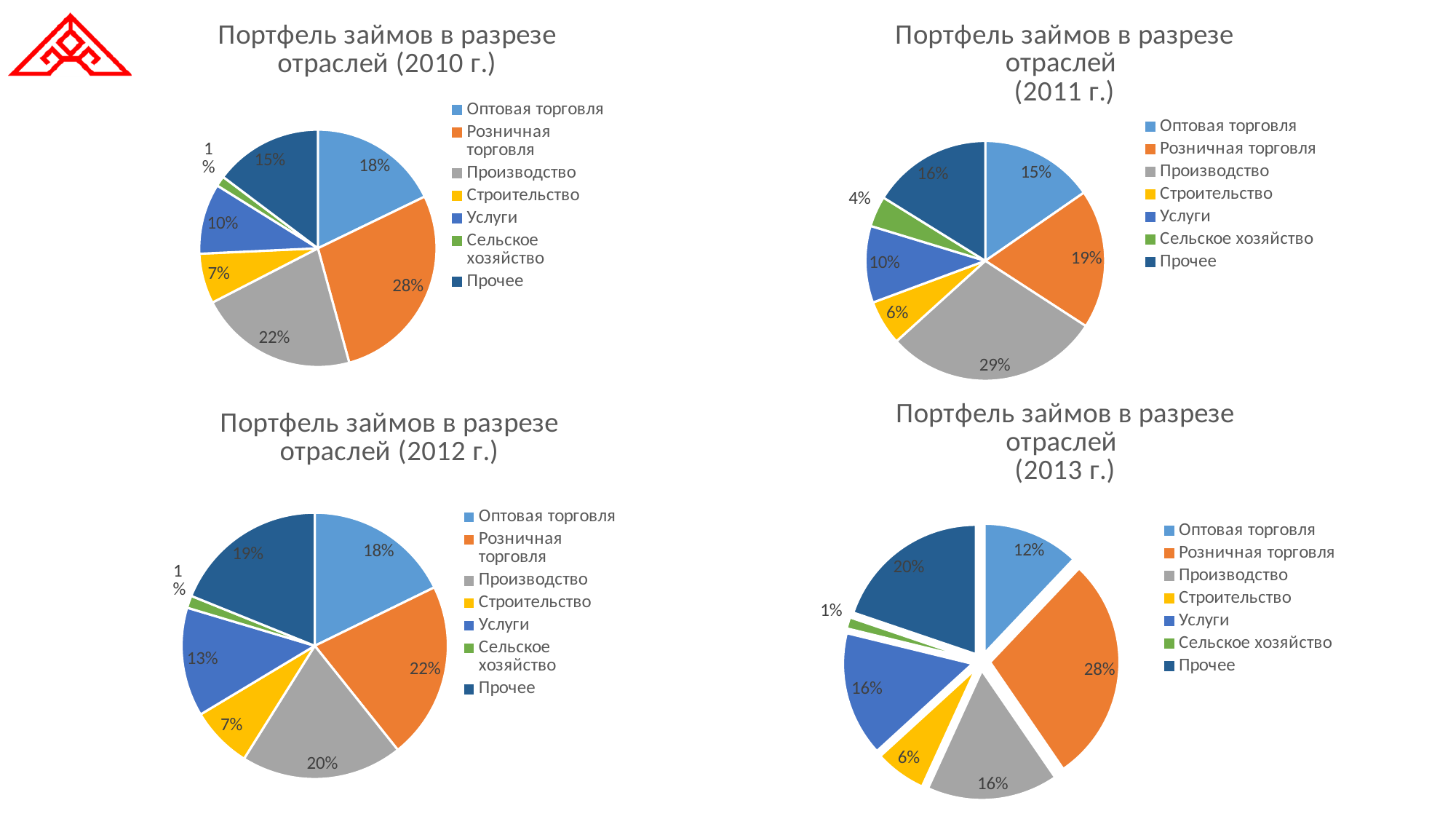
In the chart titled "Портфель займов в разрезе отраслей (2012 г.)", which is larger: Услуги or Строительство? Услуги In the chart titled "Портфель займов в разрезе отраслей (2010 г.)", what share does Розничная торговля have? 28% In the chart titled "Портфель займов в разрезе отраслей (2011 г.)", what is the share of Сельское хозяйство? 4% How many pie charts are shown on the slide? 4 In the chart titled "Портфель займов в разрезе отраслей (2013 г.)", what is the share of Прочее? 20% How many categories does the legend list in the chart titled "Портфель займов в разрезе отраслей (2010 г.)"? 7 In the chart titled "Портфель займов в разрезе отраслей (2011 г.)", what is the difference between the shares of Производство and Розничная торговля? 10% In the chart titled "Портфель займов в разрезе отраслей (2013 г.)", what is the difference between the shares of Розничная торговля and Оптовая торговля? 16% In the chart titled "Портфель займов в разрезе отраслей (2012 г.)", which category has the smallest share? Сельское хозяйство In the chart titled "Портфель займов в разрезе отраслей (2010 г.)", what is the share of Услуги? 10% In the chart titled "Портфель займов в разрезе отраслей (2011 г.)", which category has the largest share? Производство What type of chart is the chart titled "Портфель займов в разрезе отраслей (2013 г.)"? Pie chart